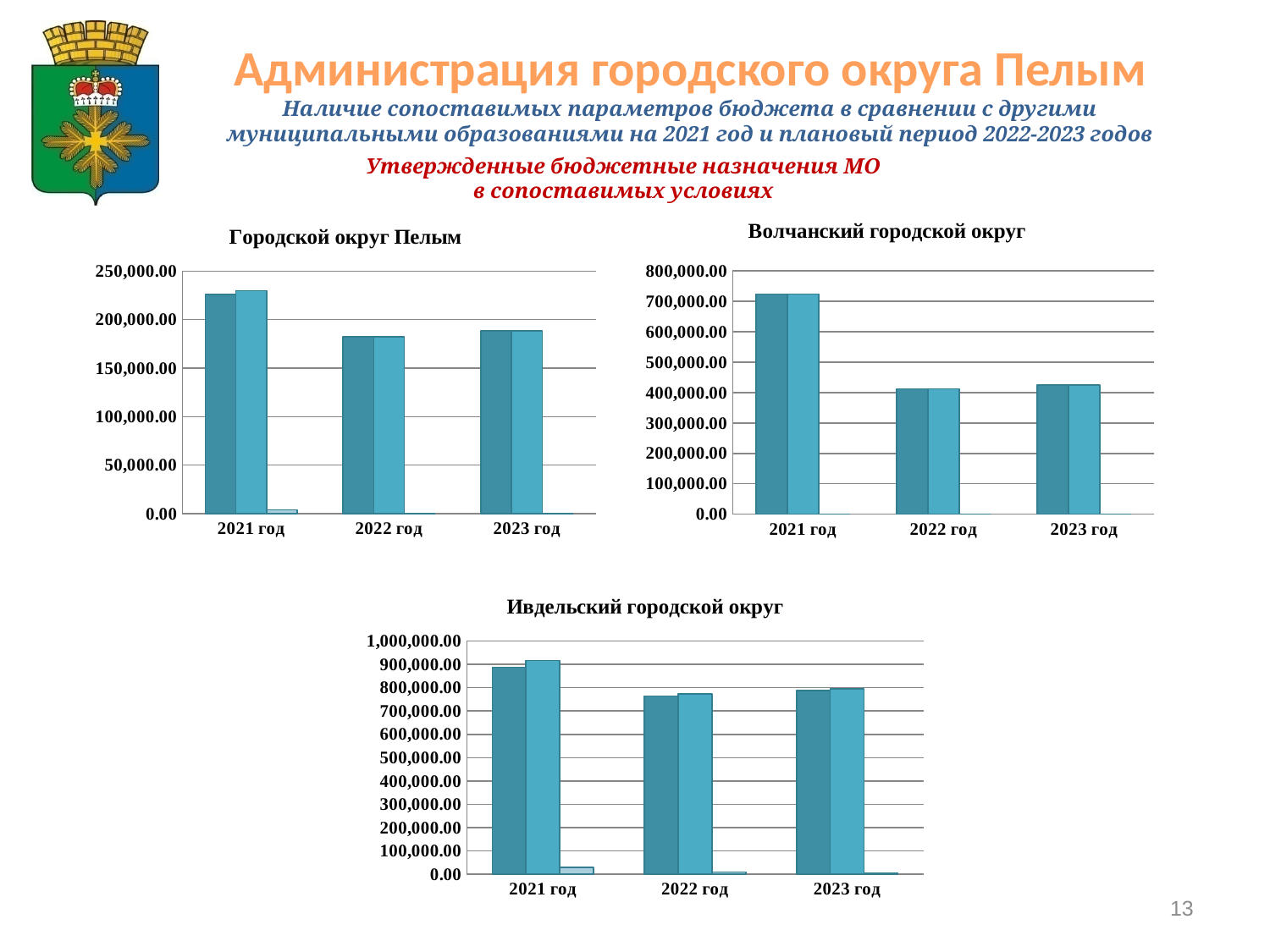
What kind of chart is the "Городской округ Пелым" chart? bar chart In the "Городской округ Пелым" chart, is the value of the first (dark teal) bar for 2021 год greater or less than 200,000.00? greater In the "Ивдельский городской округ" chart, do the values of the first (dark teal) bar rise or fall from 2021 год to 2022 год? fall In the "Ивдельский городской округ" chart, is the value of the first (dark teal) bar for 2021 год greater or less than 800,000.00? greater In the "Городской округ Пелым" chart, is the value of the first (dark teal) bar for 2022 год greater or less than 200,000.00? less In the "Волчанский городской округ" chart, which year has the tallest bars? 2021 год In the "Волчанский городской округ" chart, which year has the larger first (dark teal) bar, 2021 год or 2022 год? 2021 год How many year categories are shown on the x axis of the "Волчанский городской округ" chart? 3 In the "Городской округ Пелым" chart, which year has the tallest bars? 2021 год What is the title of the chart at the bottom of the slide? Ивдельский городской округ